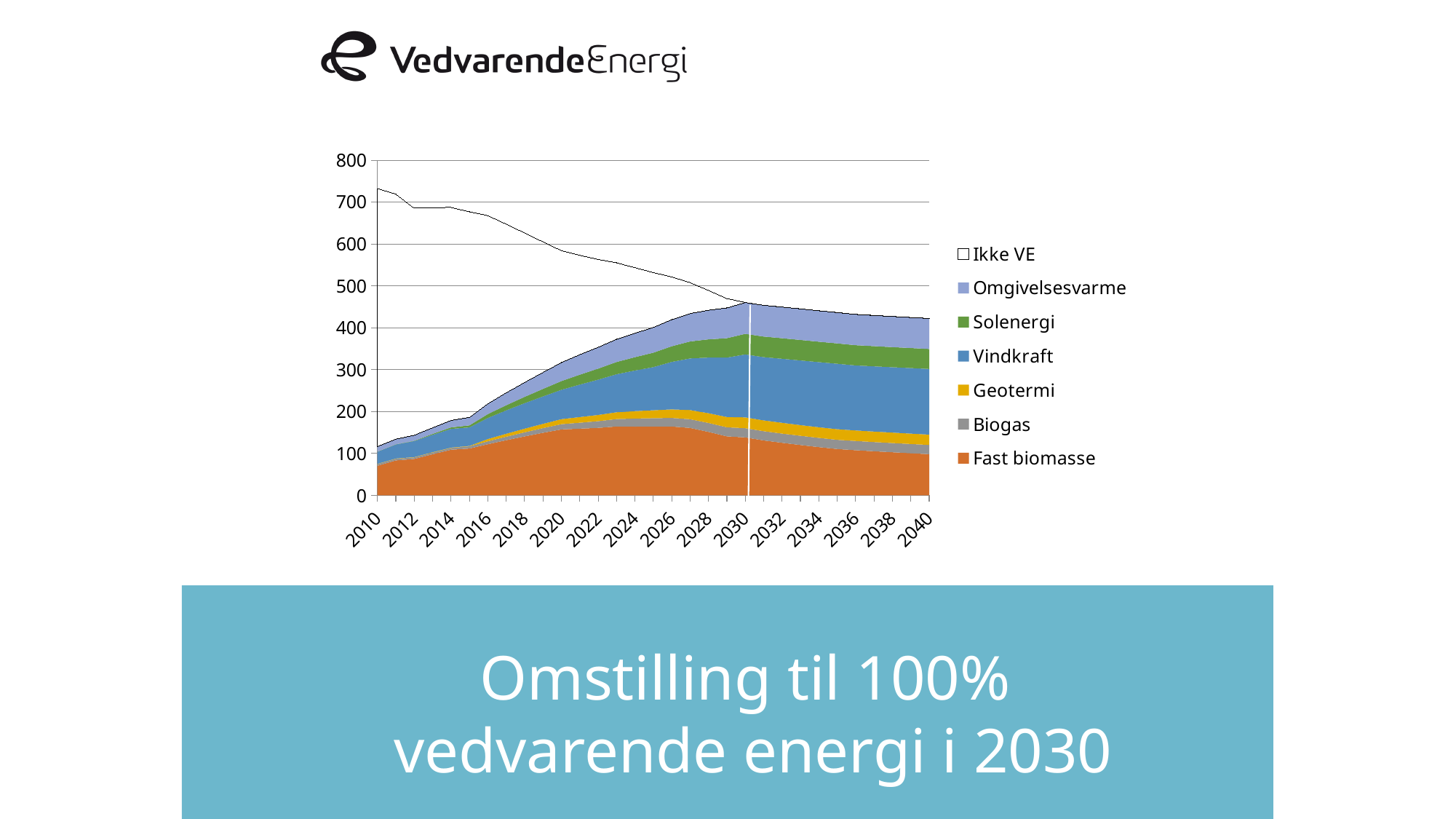
How many series does the chart legend list? 7 Which series is listed first (at the top) in the chart legend? Ikke VE Is the total stacked value in 2040 greater or less than 400? greater Is the total stacked value in 2030 greater or less than 500? less In which year does the Ikke VE area shrink to zero? 2030 Which series is plotted at the bottom of the stacked areas? Fast biomasse Is the total stacked value in 2010 greater or less than 700? greater What kind of chart is shown on the slide? Stacked area chart How many year labels are shown along the x axis of the chart? 16 Does the total height of the stacked areas rise or fall from 2010 to 2040? Fall